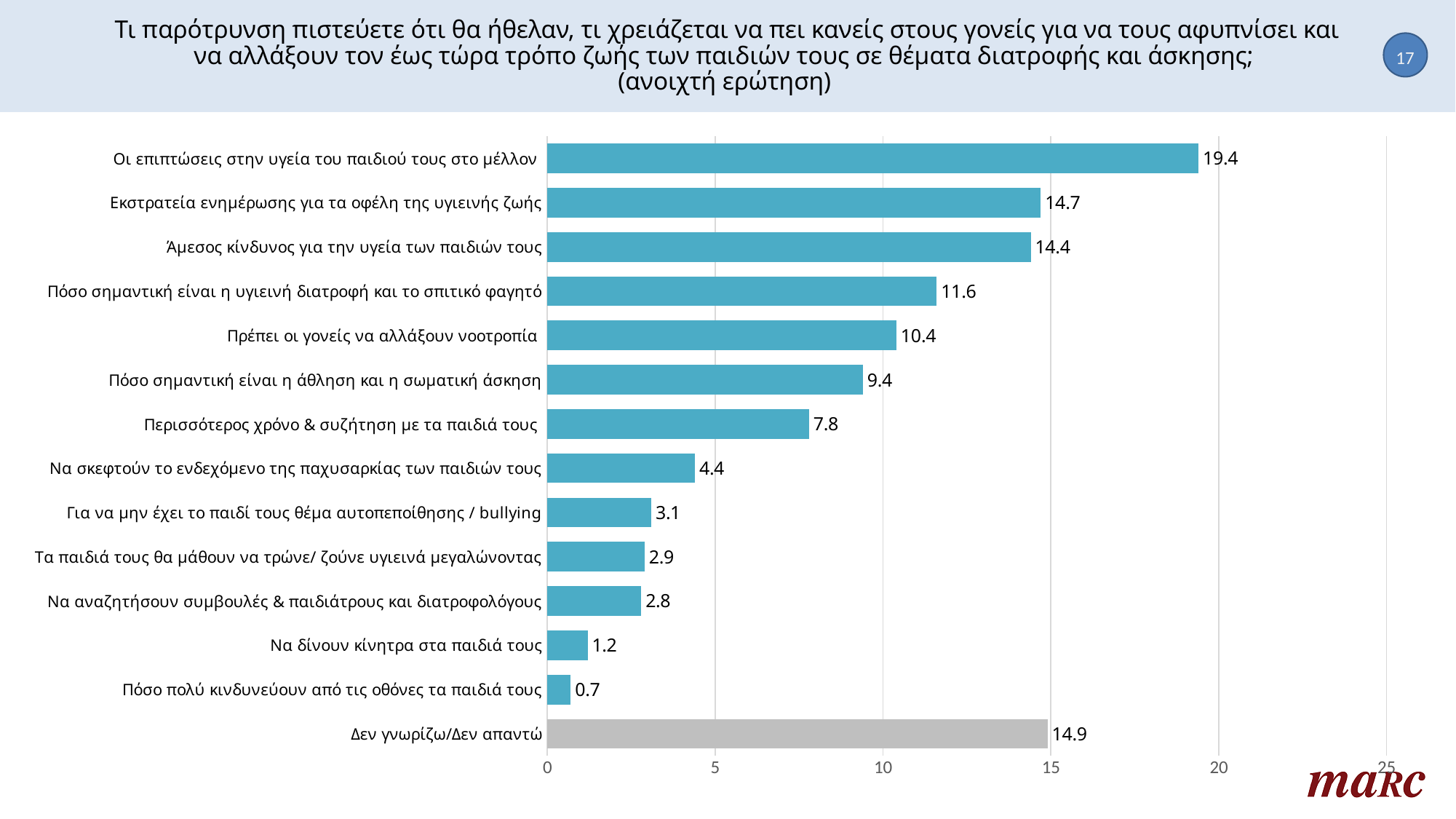
What kind of chart is shown on the slide? Bar chart What is the difference between the values for "Οι επιπτώσεις στην υγεία του παιδιού τους στο μέλλον" and "Πρέπει οι γονείς να αλλάξουν νοοτροπία"? 9.0 Which category has the lowest value? Πόσο πολύ κινδυνεύουν από τις οθόνες τα παιδιά τους What is the difference between the values for "Εκστρατεία ενημέρωσης για τα οφέλη της υγιεινής ζωής" and "Άμεσος κίνδυνος για την υγεία των παιδιών τους"? 0.3 Which bar is shown in a different colour (grey) from the others? Δεν γνωρίζω/Δεν απαντώ Which category has the highest value? Οι επιπτώσεις στην υγεία του παιδιού τους στο μέλλον Is the value for "Πόσο σημαντική είναι η υγιεινή διατροφή και το σπιτικό φαγητό" greater or less than 10? greater What is the value for "Οι επιπτώσεις στην υγεία του παιδιού τους στο μέλλον"? 19.4 What is the value for "Δεν γνωρίζω/Δεν απαντώ"? 14.9 Which is larger: the value for "Πόσο σημαντική είναι η άθληση και η σωματική άσκηση" or the value for "Να σκεφτούν το ενδεχόμενο της παχυσαρκίας των παιδιών τους"? Πόσο σημαντική είναι η άθληση και η σωματική άσκηση How many categories are shown in the chart? 14 What is the value for "Περισσότερος χρόνο & συζήτηση με τα παιδιά τους"? 7.8